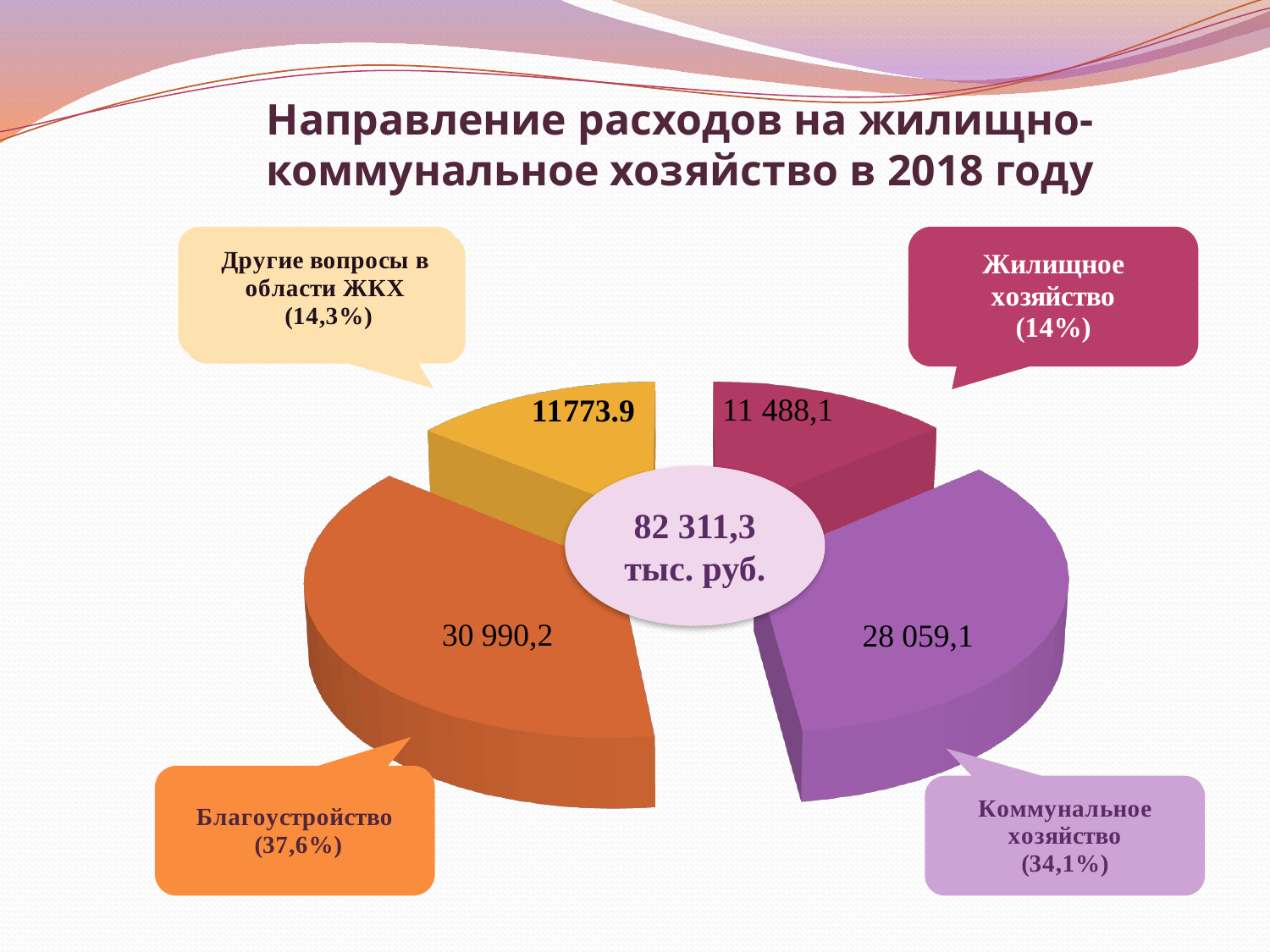
Which category has the largest slice of the pie? Благоустройство What is the total amount shown in the centre of the pie chart? 82 311,3 тыс. руб. What share of the pie does Другие вопросы в области ЖКХ represent? 14,3% What is the value shown for Жилищное хозяйство? 11 488,1 What kind of chart is shown on the slide? pie chart What is the value shown for Другие вопросы в области ЖКХ? 11773.9 Which is larger, the value for Благоустройство or the value for Коммунальное хозяйство? Благоустройство Which category has the smallest slice of the pie? Жилищное хозяйство What is the value shown for Благоустройство? 30 990,2 What is the value shown for Коммунальное хозяйство? 28 059,1 What share of the pie does Коммунальное хозяйство represent? 34,1% How many slices does the pie chart have? 4